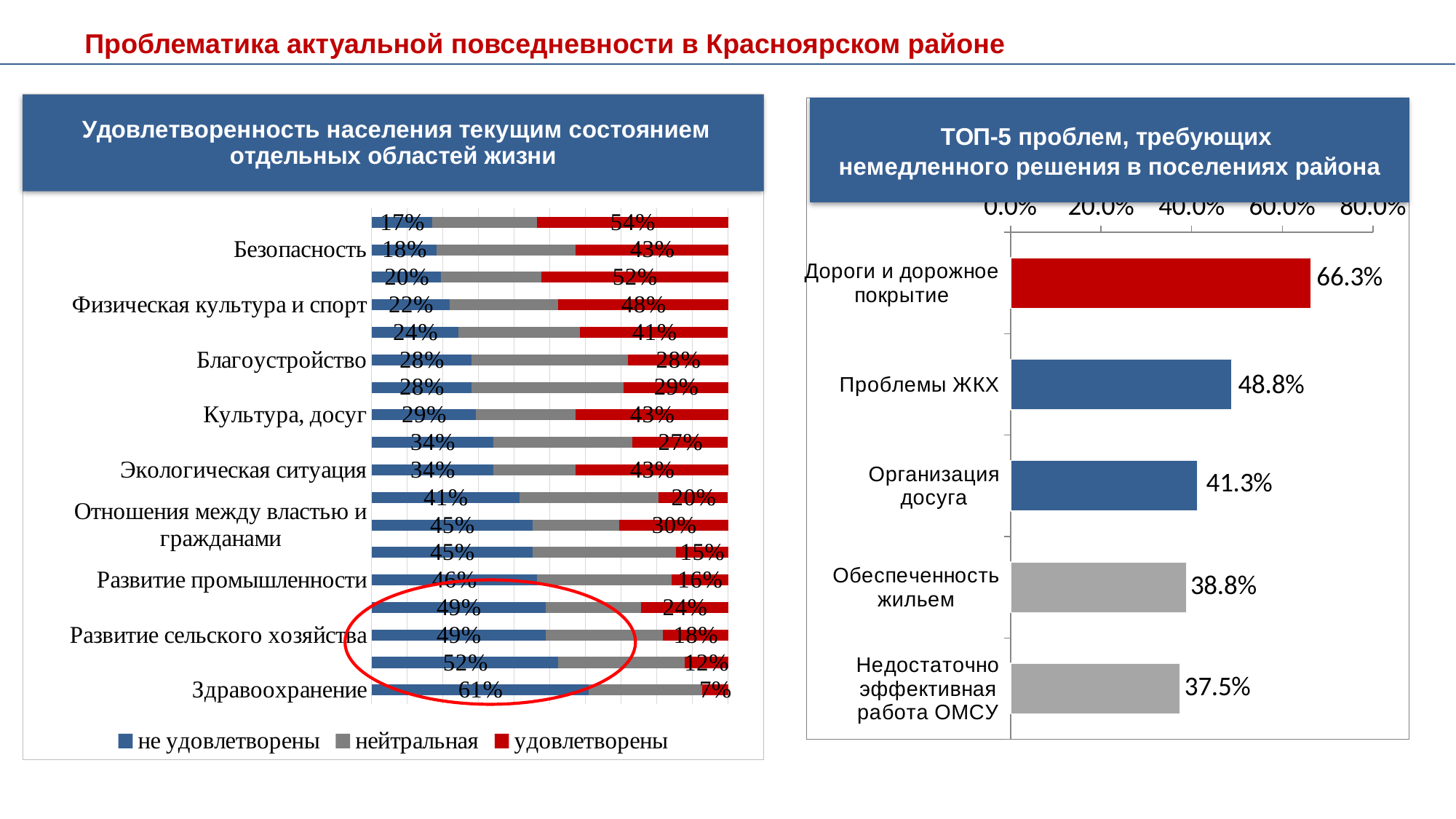
In the chart 'ТОП-5 проблем, требующих немедленного решения в поселениях района', what is the value for 'Недостаточно эффективная работа ОМСУ'? 37.5% How many categories are shown in the chart 'ТОП-5 проблем, требующих немедленного решения в поселениях района'? 5 In the chart 'ТОП-5 проблем, требующих немедленного решения в поселениях района', which is larger: 'Организация досуга' or 'Обеспеченность жильем'? Организация досуга What type of chart is the chart on the right side of the slide? Bar chart How many series does the legend of the chart 'Удовлетворенность населения текущим состоянием отдельных областей жизни' list? 3 In the chart 'Удовлетворенность населения текущим состоянием отдельных областей жизни', what is the 'удовлетворены' value for 'Здравоохранение'? 7% In the chart 'ТОП-5 проблем, требующих немедленного решения в поселениях района', what is the difference between 'Дороги и дорожное покрытие' and 'Проблемы ЖКХ'? 17.5% In the chart 'ТОП-5 проблем, требующих немедленного решения в поселениях района', which problem has the lowest value? Недостаточно эффективная работа ОМСУ In the chart 'ТОП-5 проблем, требующих немедленного решения в поселениях района', which problem has the highest value? Дороги и дорожное покрытие In the chart 'Удовлетворенность населения текущим состоянием отдельных областей жизни', what is the 'не удовлетворены' value for 'Здравоохранение'? 61% In the chart 'ТОП-5 проблем, требующих немедленного решения в поселениях района', what is the value for 'Дороги и дорожное покрытие'? 66.3% In the chart 'ТОП-5 проблем, требующих немедленного решения в поселениях района', what is the value for 'Проблемы ЖКХ'? 48.8%